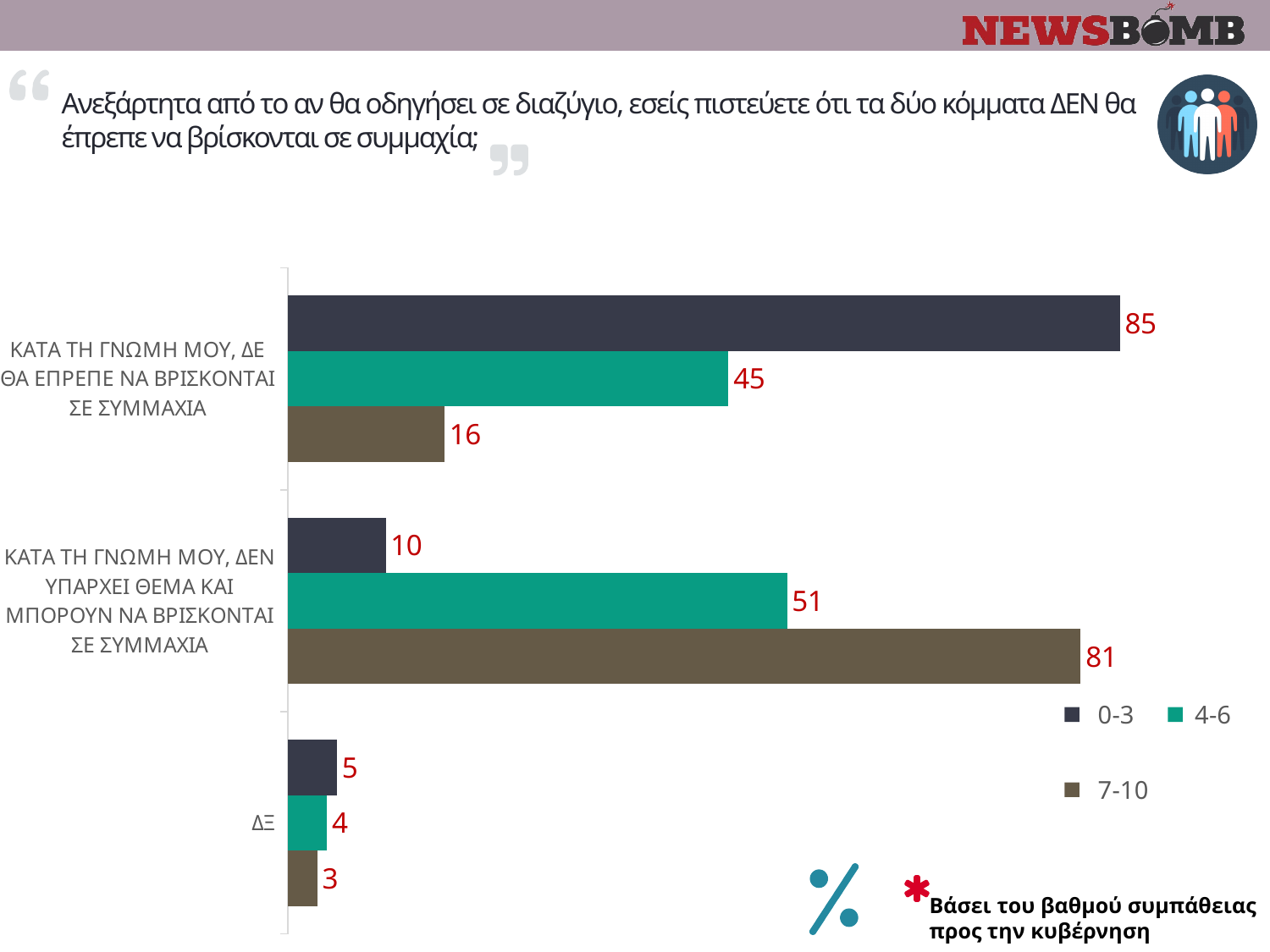
Which series has the lowest value for "ΚΑΤΑ ΤΗ ΓΝΩΜΗ ΜΟΥ, ΔΕ ΘΑ ΕΠΡΕΠΕ ΝΑ ΒΡΙΣΚΟΝΤΑΙ ΣΕ ΣΥΜΜΑΧΙΑ"? 7-10 What type of chart is shown on the slide? bar chart Which series has the highest value for "ΚΑΤΑ ΤΗ ΓΝΩΜΗ ΜΟΥ, ΔΕΝ ΥΠΑΡΧΕΙ ΘΕΜΑ ΚΑΙ ΜΠΟΡΟΥΝ ΝΑ ΒΡΙΣΚΟΝΤΑΙ ΣΕ ΣΥΜΜΑΧΙΑ"? 7-10 Which legend entry is shown in green? 4-6 What is the value of the 0-3 series for "ΚΑΤΑ ΤΗ ΓΝΩΜΗ ΜΟΥ, ΔΕ ΘΑ ΕΠΡΕΠΕ ΝΑ ΒΡΙΣΚΟΝΤΑΙ ΣΕ ΣΥΜΜΑΧΙΑ"? 85 How many categories are shown on the chart? 3 What is the difference between the 7-10 and 0-3 values for "ΚΑΤΑ ΤΗ ΓΝΩΜΗ ΜΟΥ, ΔΕΝ ΥΠΑΡΧΕΙ ΘΕΜΑ ΚΑΙ ΜΠΟΡΟΥΝ ΝΑ ΒΡΙΣΚΟΝΤΑΙ ΣΕ ΣΥΜΜΑΧΙΑ"? 71 What is the value of the 7-10 series for "ΚΑΤΑ ΤΗ ΓΝΩΜΗ ΜΟΥ, ΔΕΝ ΥΠΑΡΧΕΙ ΘΕΜΑ ΚΑΙ ΜΠΟΡΟΥΝ ΝΑ ΒΡΙΣΚΟΝΤΑΙ ΣΕ ΣΥΜΜΑΧΙΑ"? 81 Which is larger: the 4-6 value for "ΚΑΤΑ ΤΗ ΓΝΩΜΗ ΜΟΥ, ΔΕΝ ΥΠΑΡΧΕΙ ΘΕΜΑ ΚΑΙ ΜΠΟΡΟΥΝ ΝΑ ΒΡΙΣΚΟΝΤΑΙ ΣΕ ΣΥΜΜΑΧΙΑ" or the 4-6 value for "ΚΑΤΑ ΤΗ ΓΝΩΜΗ ΜΟΥ, ΔΕ ΘΑ ΕΠΡΕΠΕ ΝΑ ΒΡΙΣΚΟΝΤΑΙ ΣΕ ΣΥΜΜΑΧΙΑ"? ΚΑΤΑ ΤΗ ΓΝΩΜΗ ΜΟΥ, ΔΕΝ ΥΠΑΡΧΕΙ ΘΕΜΑ ΚΑΙ ΜΠΟΡΟΥΝ ΝΑ ΒΡΙΣΚΟΝΤΑΙ ΣΕ ΣΥΜΜΑΧΙΑ What is the difference between the 0-3 and 4-6 values for "ΚΑΤΑ ΤΗ ΓΝΩΜΗ ΜΟΥ, ΔΕ ΘΑ ΕΠΡΕΠΕ ΝΑ ΒΡΙΣΚΟΝΤΑΙ ΣΕ ΣΥΜΜΑΧΙΑ"? 40 How many series does the legend list? 3 What is the value of the 4-6 series for "ΔΞ"? 4